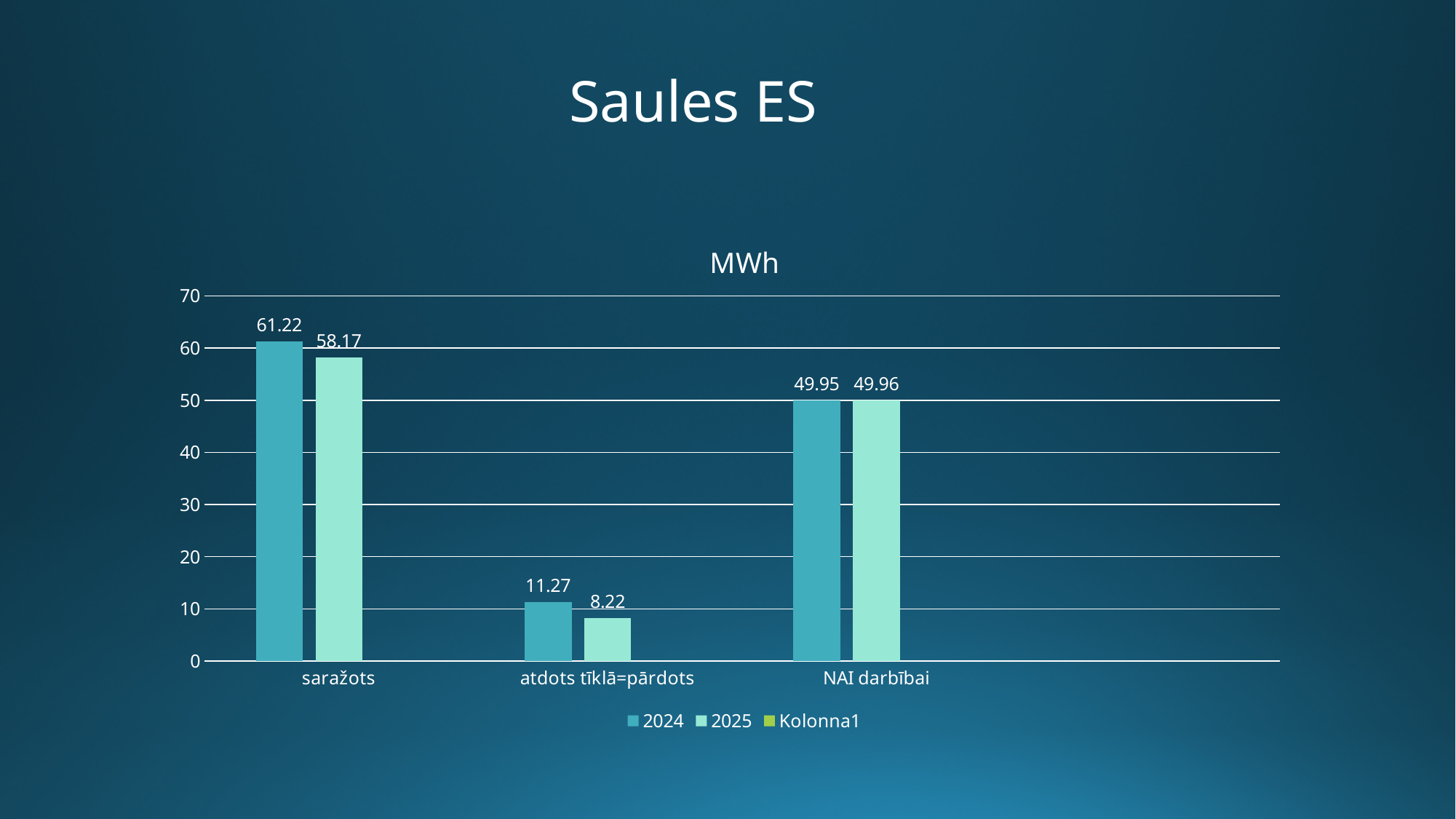
Which category has the highest 2024 value? saražots What is the 2025 value for saražots? 58.17 What is the difference between the 2024 and 2025 values for atdots tīklā=pārdots? 3.05 Which category has the lowest 2025 value? atdots tīklā=pārdots How many series does the legend list? 3 What kind of chart is shown on the slide? bar chart What is the difference between the 2024 and 2025 values for saražots? 3.05 How many categories are shown on the x axis? 3 What is the 2025 value for atdots tīklā=pārdots? 8.22 Which is larger, the 2024 value for saražots or the 2024 value for NAI darbībai? saražots What is the 2024 value for saražots? 61.22 What is the 2024 value for NAI darbībai? 49.95